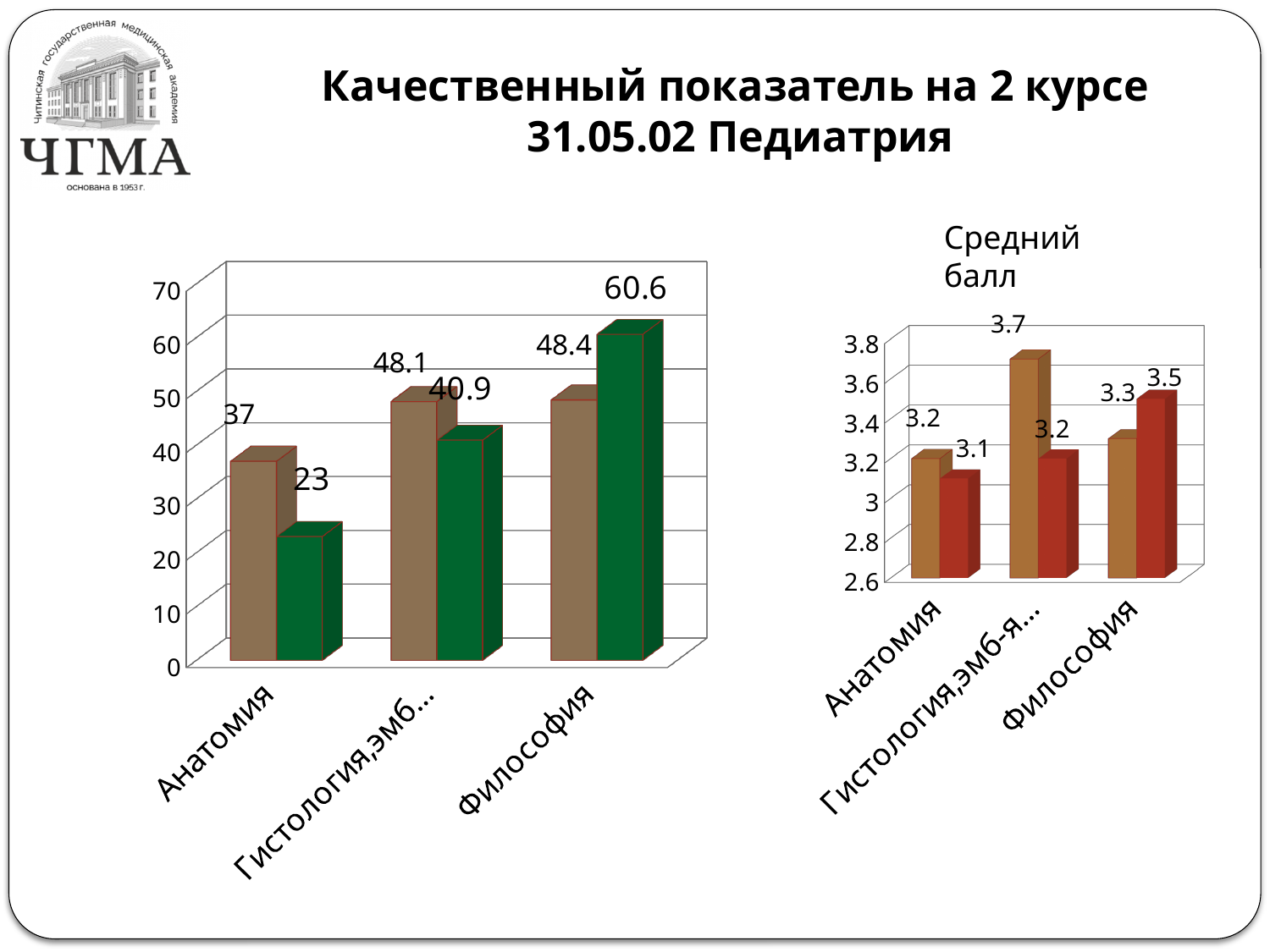
On the left chart, what is the value of the green bar for Анатомия? 23 On the chart titled Средний балл, what is the difference between the tan and red bars for Гистология,эмб-я...? 0.5 On the left chart, what is the value of the brown bar for Анатомия? 37 On the chart titled Средний балл, what is the value of the red bar for Философия? 3.5 On the left chart, which category has the highest green bar? Философия On the left chart, which is larger for Анатомия: the brown bar or the green bar? the brown bar On the chart titled Средний балл, which category has the lowest red bar? Анатомия On the left chart, what is the difference between the green and brown bars for Философия? 12.2 What kind of chart is the chart titled Средний балл? bar chart On the left chart, how many categories are shown on the x axis? 3 On the chart titled Средний балл, what is the value of the tan bar for Гистология,эмб-я...? 3.7 On the left chart, what is the value of the green bar for Философия? 60.6